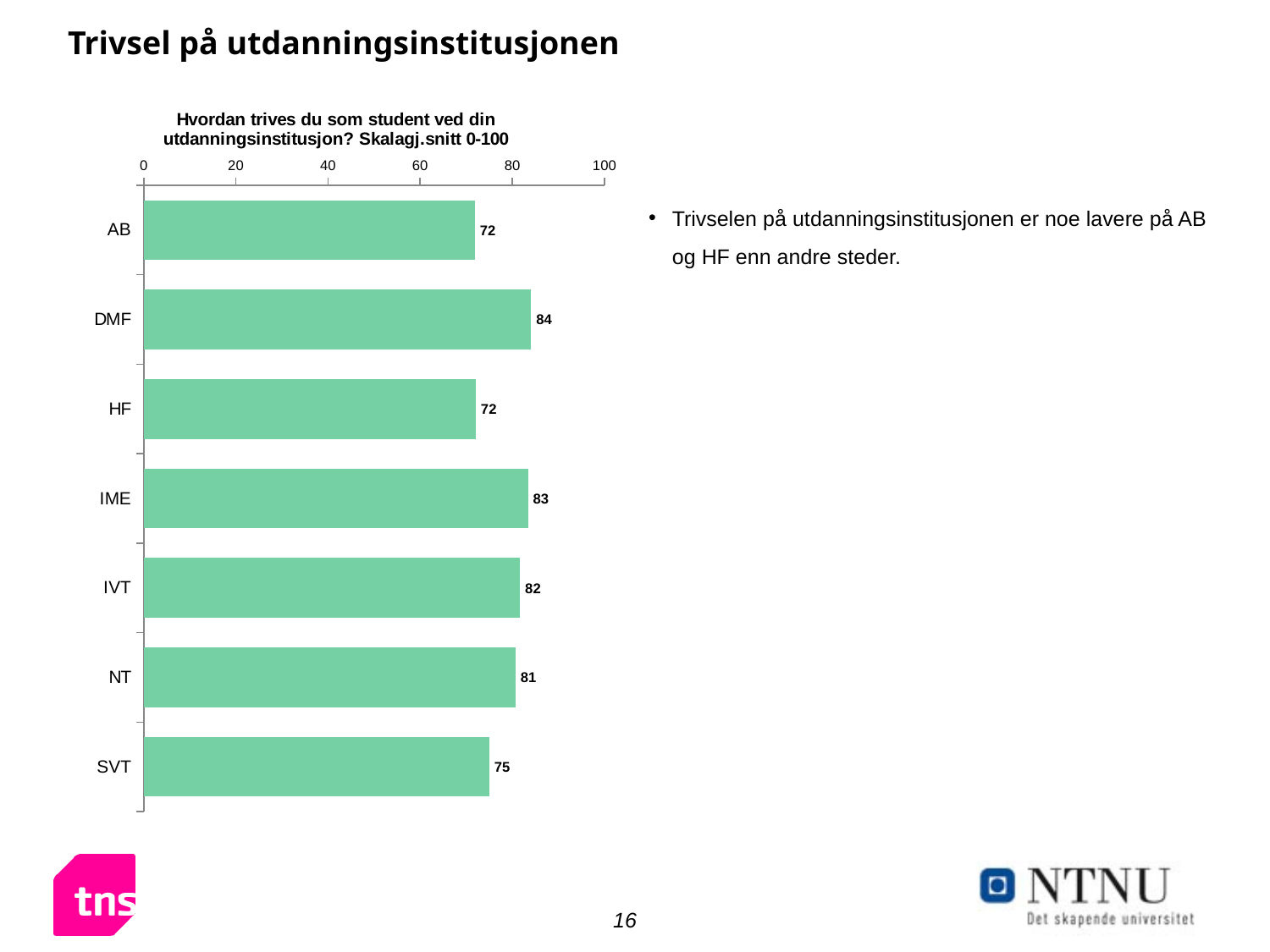
What is the value for DMF? 84 Which categories share the lowest value? AB and HF What is the difference between the values for IME and NT? 2 Is the value for NT greater or less than 60? greater What is the value for IVT? 82 What is the maximum value shown on the chart's axis? 100 What kind of chart is shown on the slide? bar chart How many categories are shown in the chart? 7 What is the difference between the values for DMF and AB? 12 Which is larger, the value for IME or the value for SVT? IME What is the value for SVT? 75 Which category has the highest value? DMF